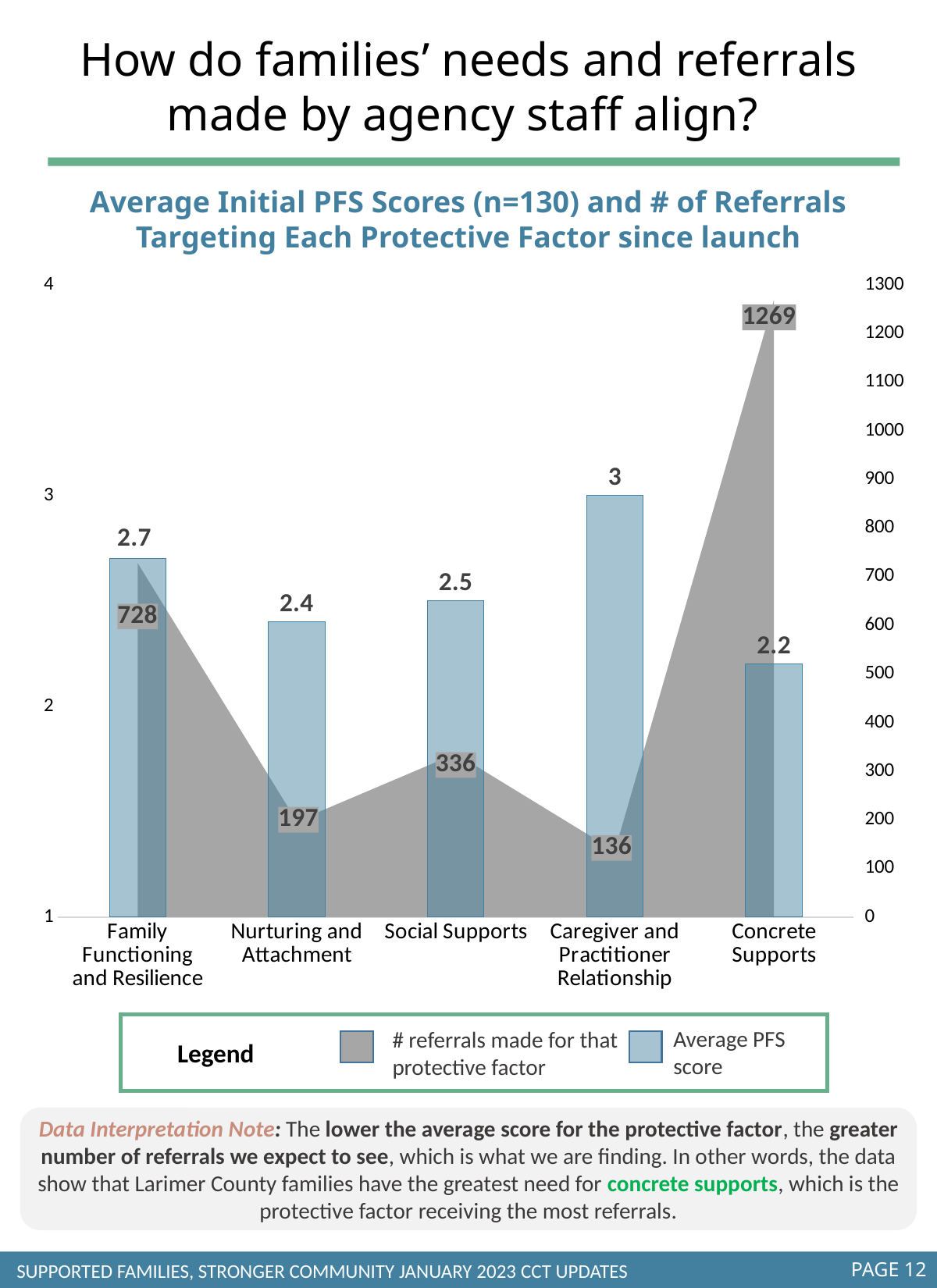
What is the average PFS score for Caregiver and Practitioner Relationship? 3 What does the grey shaded series in the legend represent? # referrals made for that protective factor How many series does the legend list? 2 How many referrals were made for Social Supports? 336 Which protective factor has the fewest referrals? Caregiver and Practitioner Relationship Which protective factor has the highest number of referrals? Concrete Supports Which protective factor has the lowest average PFS score? Concrete Supports What is the difference in number of referrals between Family Functioning and Resilience and Nurturing and Attachment? 531 How many protective factors are shown on the x axis? 5 Which has a higher average PFS score, Social Supports or Nurturing and Attachment? Social Supports How many referrals were made for Concrete Supports? 1269 What is the average PFS score for Nurturing and Attachment? 2.4